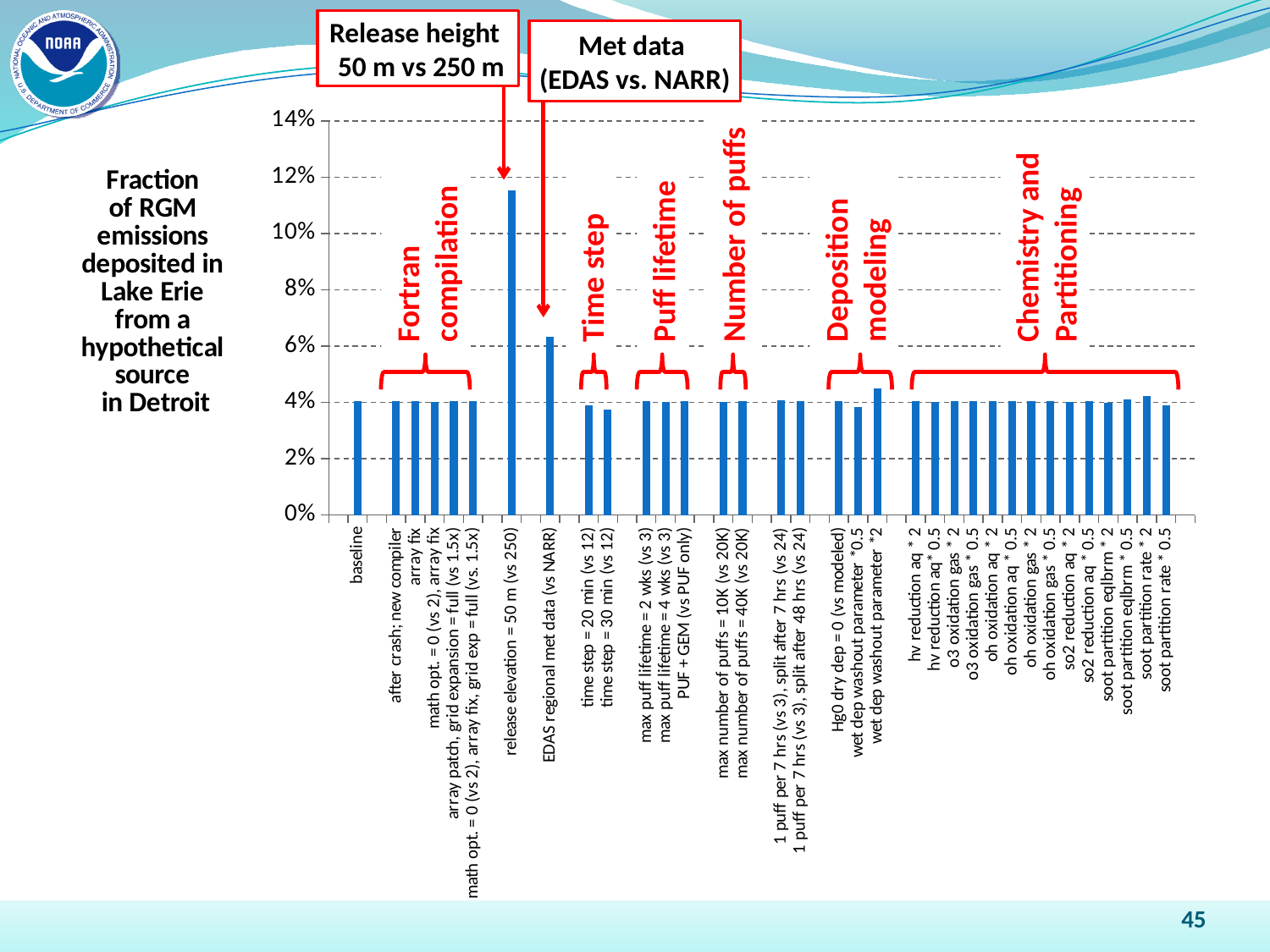
Which is larger, the value for 'release elevation = 50 m (vs 250)' or for 'EDAS regional met data (vs NARR)'? release elevation = 50 m (vs 250) What kind of chart is shown on the slide? bar chart Is the value for 'release elevation = 50 m (vs 250)' greater or less than 10%? greater How many bars (categories) are plotted in the chart? 34 Which category has the highest fraction of RGM emissions deposited in Lake Erie? release elevation = 50 m (vs 250) Is the value for 'EDAS regional met data (vs NARR)' greater or less than 4%? greater Which is larger, the value for 'EDAS regional met data (vs NARR)' or for 'baseline'? EDAS regional met data (vs NARR) What is the highest value shown on the y-axis of the chart? 14% According to the text to the left of the chart, what quantity does the chart plot? Fraction of RGM emissions deposited in Lake Erie from a hypothetical source in Detroit Is the value for 'wet dep washout parameter *2' greater or less than 6%? less Which is larger, the value for 'time step = 30 min (vs 12)' or for 'release elevation = 50 m (vs 250)'? release elevation = 50 m (vs 250)